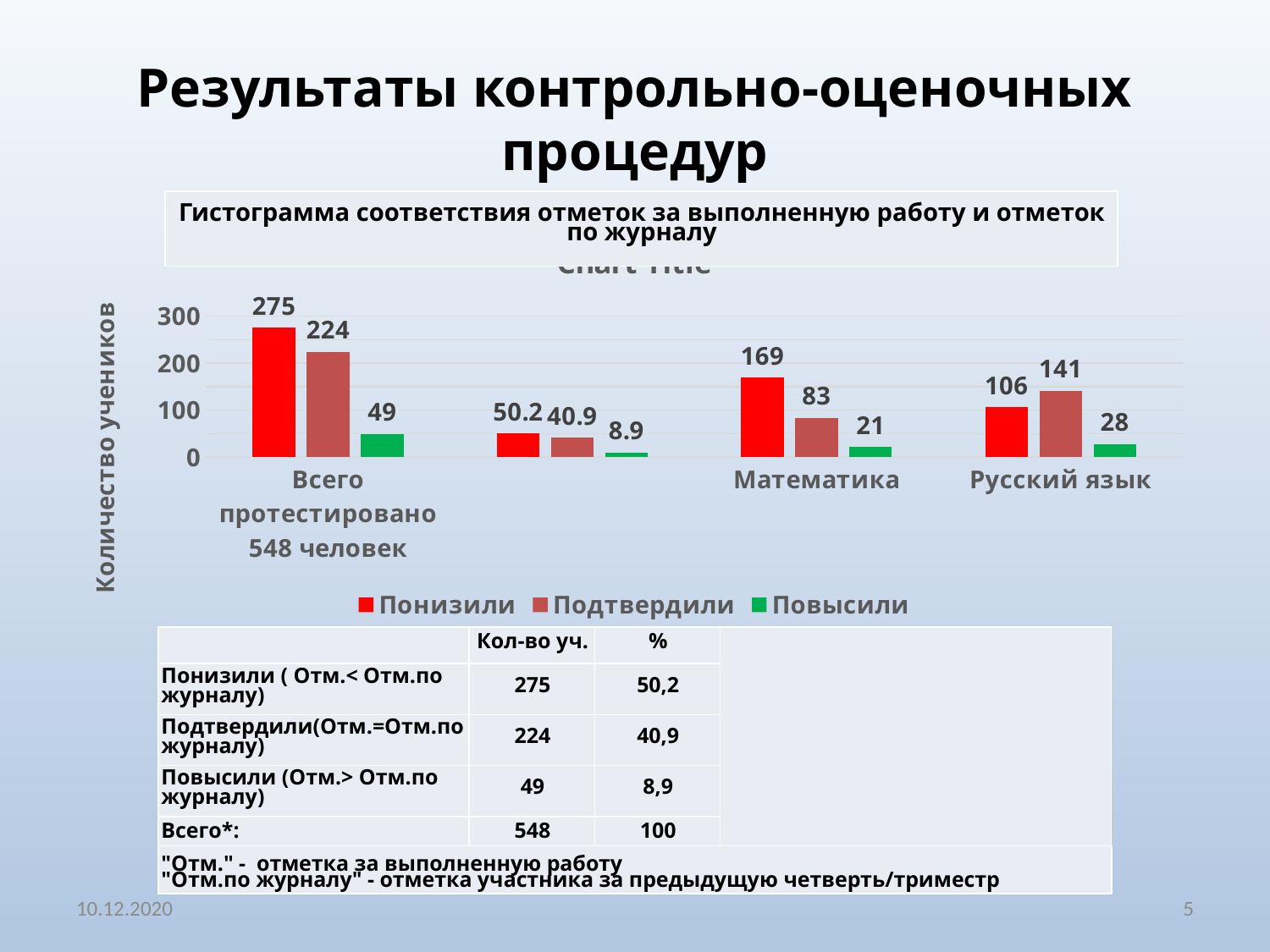
What is the value of the Понизили series for Математика? 169 What kind of chart is shown on the slide? bar chart Is the Подтвердили value for 'Всего протестировано 548 человек' greater or less than 200? greater What is the value of the Подтвердили series for Русский язык? 141 What is the difference between the Понизили and Подтвердили values for Математика? 86 What is the difference between the Подтвердили and Понизили values for Русский язык? 35 For Математика, which is larger: Понизили or Подтвердили? Понизили For Русский язык, which is larger: Понизили or Подтвердили? Подтвердили What is the value of the Повысили series for the category 'Всего протестировано 548 человек'? 49 What is the value of the Подтвердили series for Математика? 83 Which category has the highest value in the Понизили series? Всего протестировано 548 человек How many series does the legend list? 3